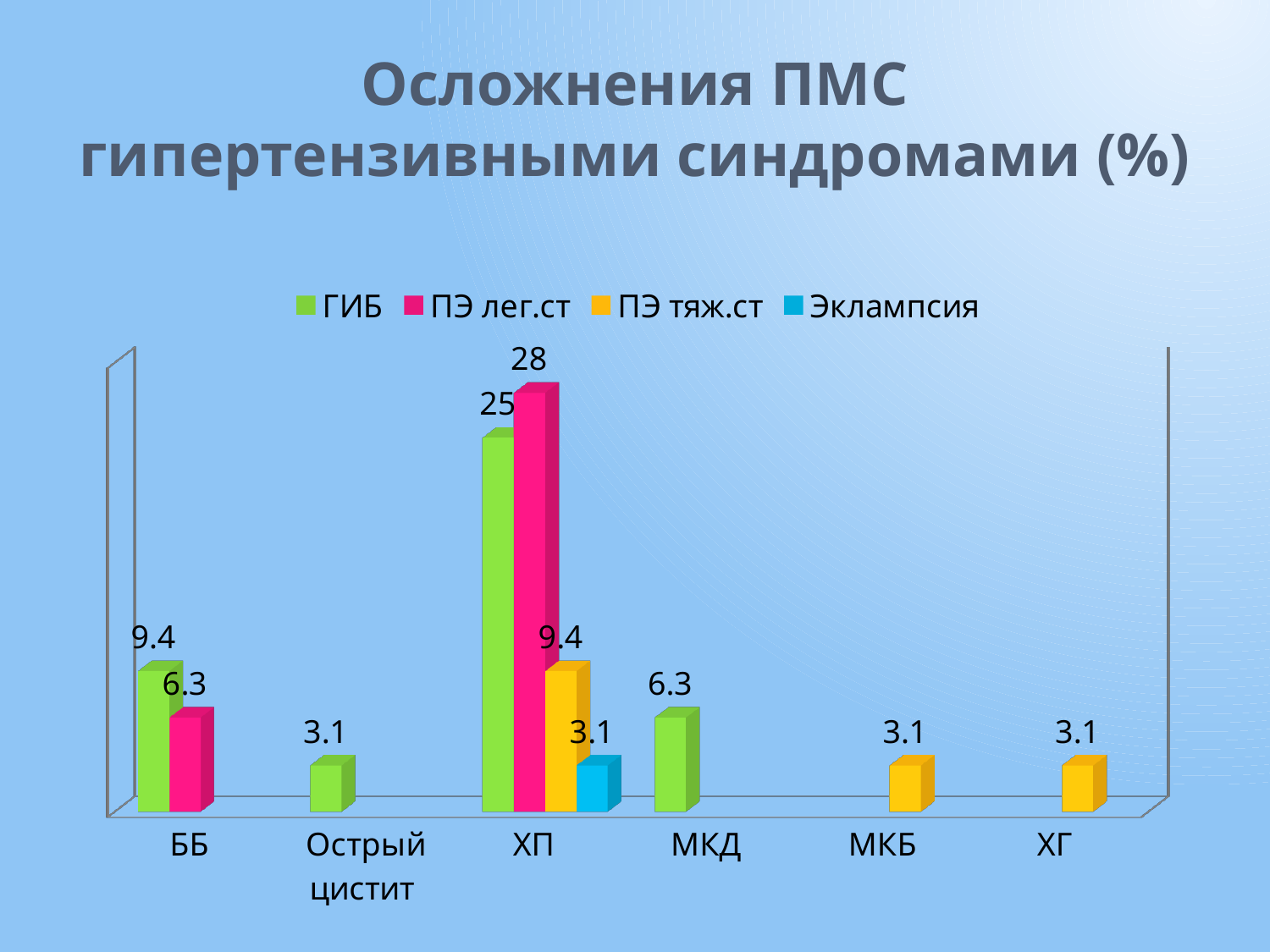
How many categories are shown on the x axis? 6 What is the difference between the ГИБ and ПЭ лег.ст values in the ББ category? 3.1 Which is larger: the ГИБ value for ББ or the ГИБ value for МКД? ББ What is the value for Эклампсия in the ХП category? 3.1 What kind of chart is shown on the slide? Bar chart How many series does the legend list? 4 What is the value for ГИБ in the ББ category? 9.4 Which category has the highest value for the ГИБ series? ХП What is the difference between the ПЭ лег.ст and ГИБ values in the ХП category? 3 What is the value for ПЭ тяж.ст in the ХП category? 9.4 In the ХП category, which is larger: ГИБ or ПЭ лег.ст? ПЭ лег.ст What is the value for ПЭ лег.ст in the ХП category? 28